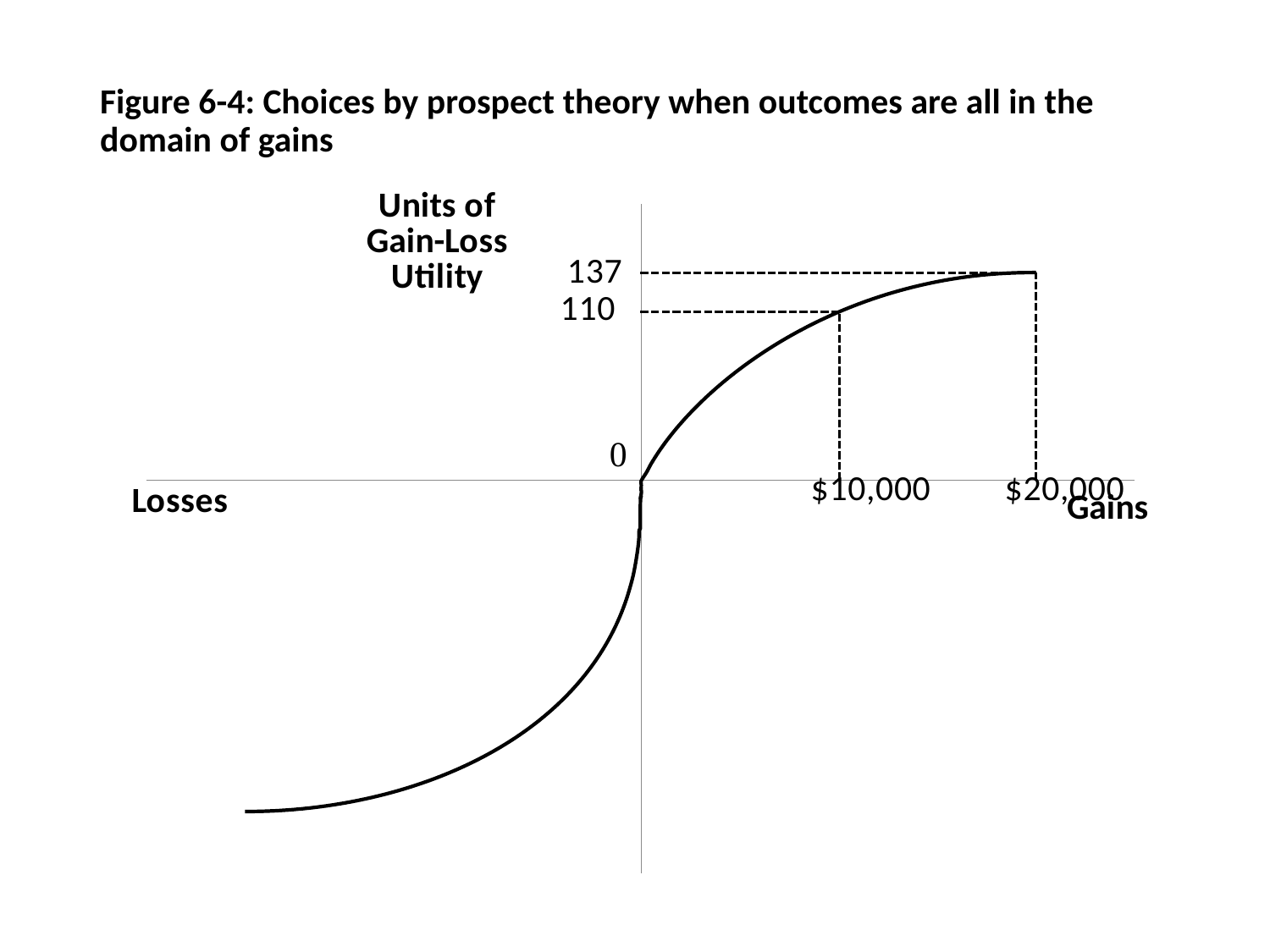
Which gain has the higher gain-loss utility, $10,000 or $20,000? $20,000 What is the title of the figure? Figure 6-4: Choices by prospect theory when outcomes are all in the domain of gains Does the curve rise or fall as gains increase along the x axis? rise What is the label on the vertical axis of the chart? Units of Gain-Loss Utility What is the gain-loss utility for a gain of $10,000? 110 What is the gain-loss utility at the origin of the chart? 0 What is the difference in gain-loss utility between a gain of $20,000 and a gain of $10,000? 27 What kind of chart is shown on the slide? line chart Is the gain-loss utility for a gain of $10,000 greater or less than 0? greater What is the gain-loss utility for a gain of $20,000? 137